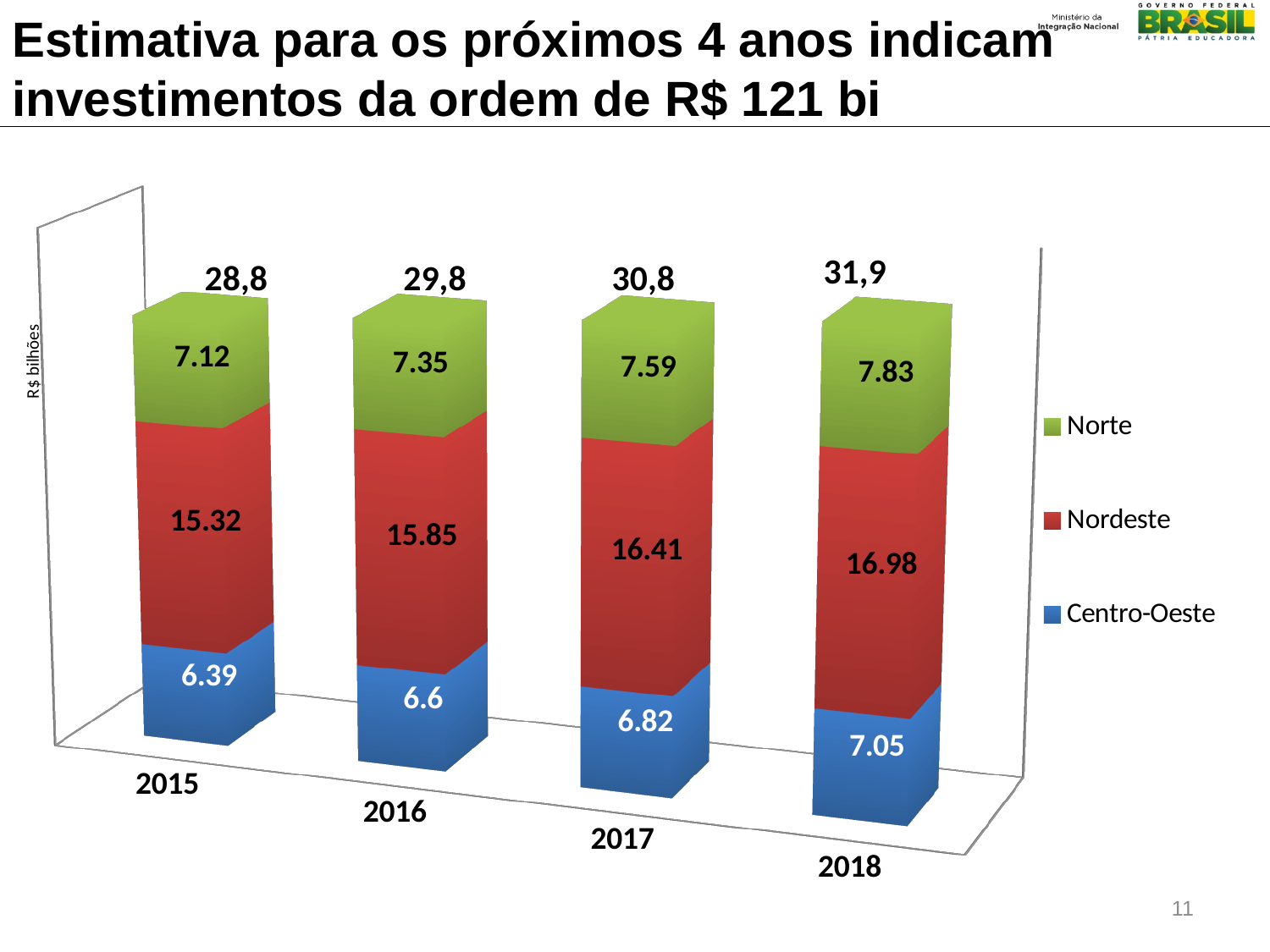
What is the value for Centro-Oeste in 2015? 6.39 How many series does the legend list? 3 Which year has the lowest value for Centro-Oeste? 2015 What is the difference between the Nordeste values for 2018 and 2015? 1.66 What kind of chart is shown on the slide? Stacked bar chart What is the total shown above the stacked bar for 2016? 29,8 Do the Nordeste values rise or fall from 2015 to 2018? Rise What is the value for Norte in 2018? 7.83 What is the value for Nordeste in 2017? 16.41 How many years are shown on the x axis? 4 Which is larger, the Norte value in 2016 or the Centro-Oeste value in 2018? Norte in 2016 Which year has the highest total investment? 2018